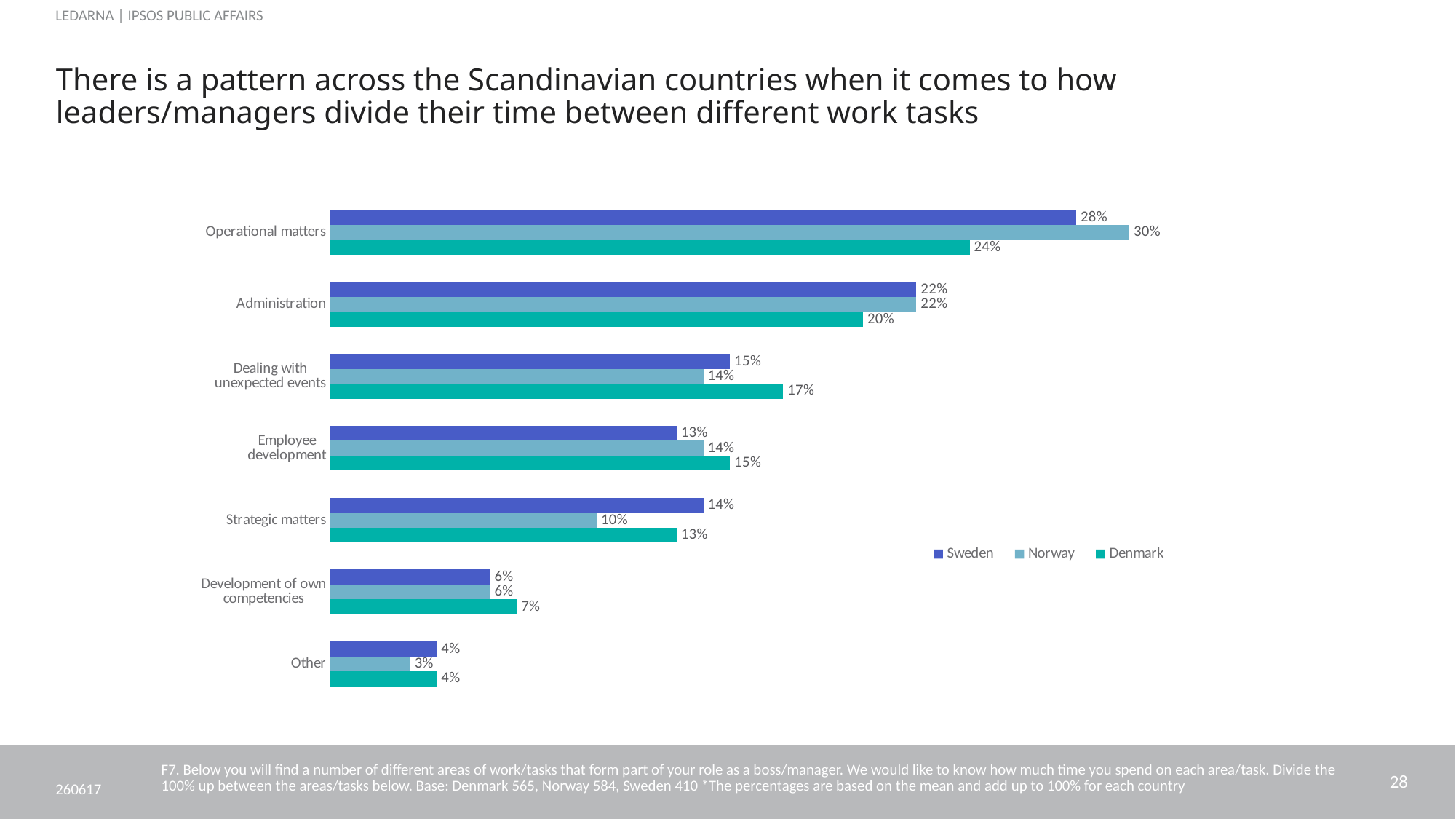
Which country does the teal/green series in the legend represent? Denmark What kind of chart is shown on the slide? Bar chart What is the difference between Norway and Denmark on Operational matters? 6% What is the value for Sweden on Strategic matters? 14% Which is larger on Strategic matters: Sweden or Norway? Sweden What percentage of time do Norwegian leaders spend on Operational matters? 30% What is the value for Denmark on Dealing with unexpected events? 17% What is the value for Norway on Other? 3% How many series does the legend list? 3 How many work task categories are shown in the chart? 7 Which category has the lowest value for Sweden? Other Which category has the highest value for Denmark? Operational matters